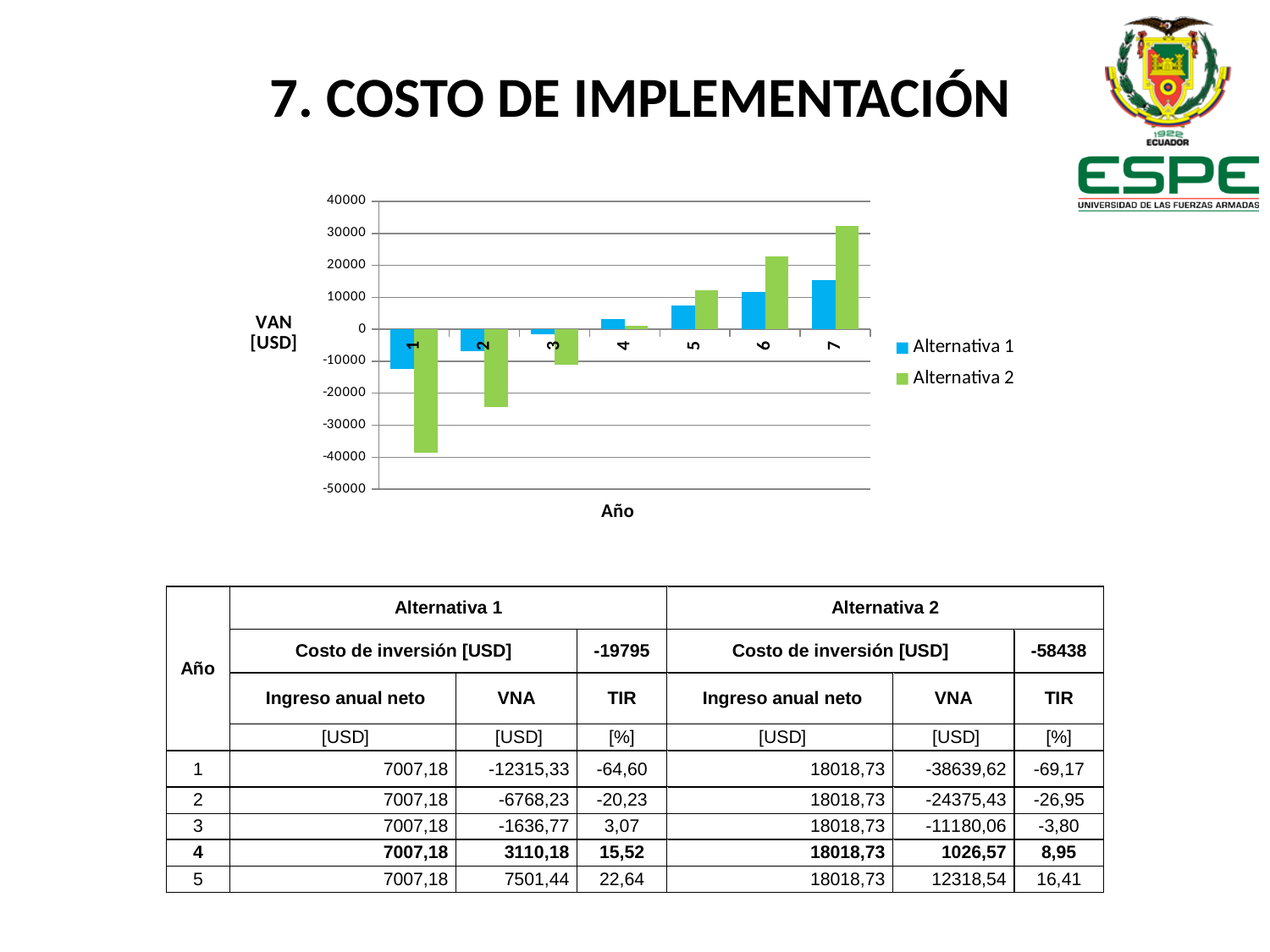
Is the VAN value for Alternativa 2 in year 6 greater or less than 20000? greater How many years (categories) are plotted along the x axis of the chart? 7 In which year does Alternativa 2 reach its highest VAN value in the chart? 7 What is the label on the vertical axis of the chart? VAN [USD] In year 1, which series has the lower VAN value, Alternativa 1 or Alternativa 2? Alternativa 2 Do the VAN values for Alternativa 1 rise or fall from year 1 to year 7? rise How many series does the chart legend list? 2 In which year does Alternativa 2 have its lowest VAN value in the chart? 1 Is the VAN value for Alternativa 2 in year 1 greater or less than -30000? less Is the VAN value for Alternativa 1 in year 7 greater or less than 10000? greater What kind of chart is shown on the slide? bar chart In year 7, which series has the larger VAN value, Alternativa 1 or Alternativa 2? Alternativa 2